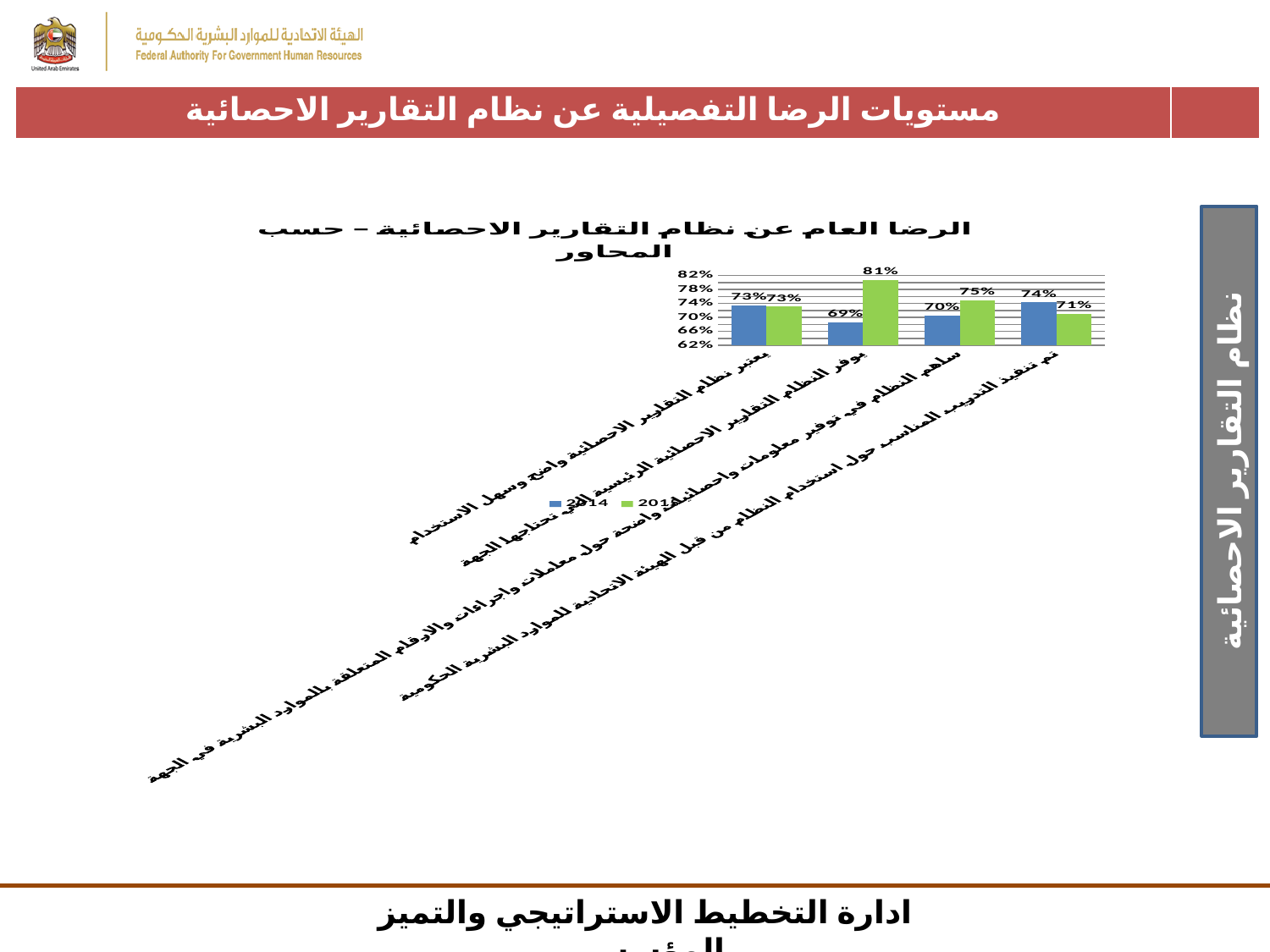
For the second category from the left, what is the difference between the 2015 and 2014 values? 12 percentage points What is the 2014 value for the second category from the left? 69% What kind of chart is shown on the slide? bar chart What are the two series named in the chart's legend? 2014 and 2015 For the fourth category from the left, what is the difference between the 2014 and 2015 values? 3 percentage points Which bar has the highest value in the chart? 2015 bar of the second category from the left (81%) How many series does the chart's legend list? 2 What is the lowest value shown in the chart? 69% For the third category from the left, which series has the larger value, 2014 or 2015? 2015 What is the 2015 value for the second category from the left? 81% How many categories are plotted along the x axis of the chart? 4 What is the 2014 value for the fourth category from the left? 74%